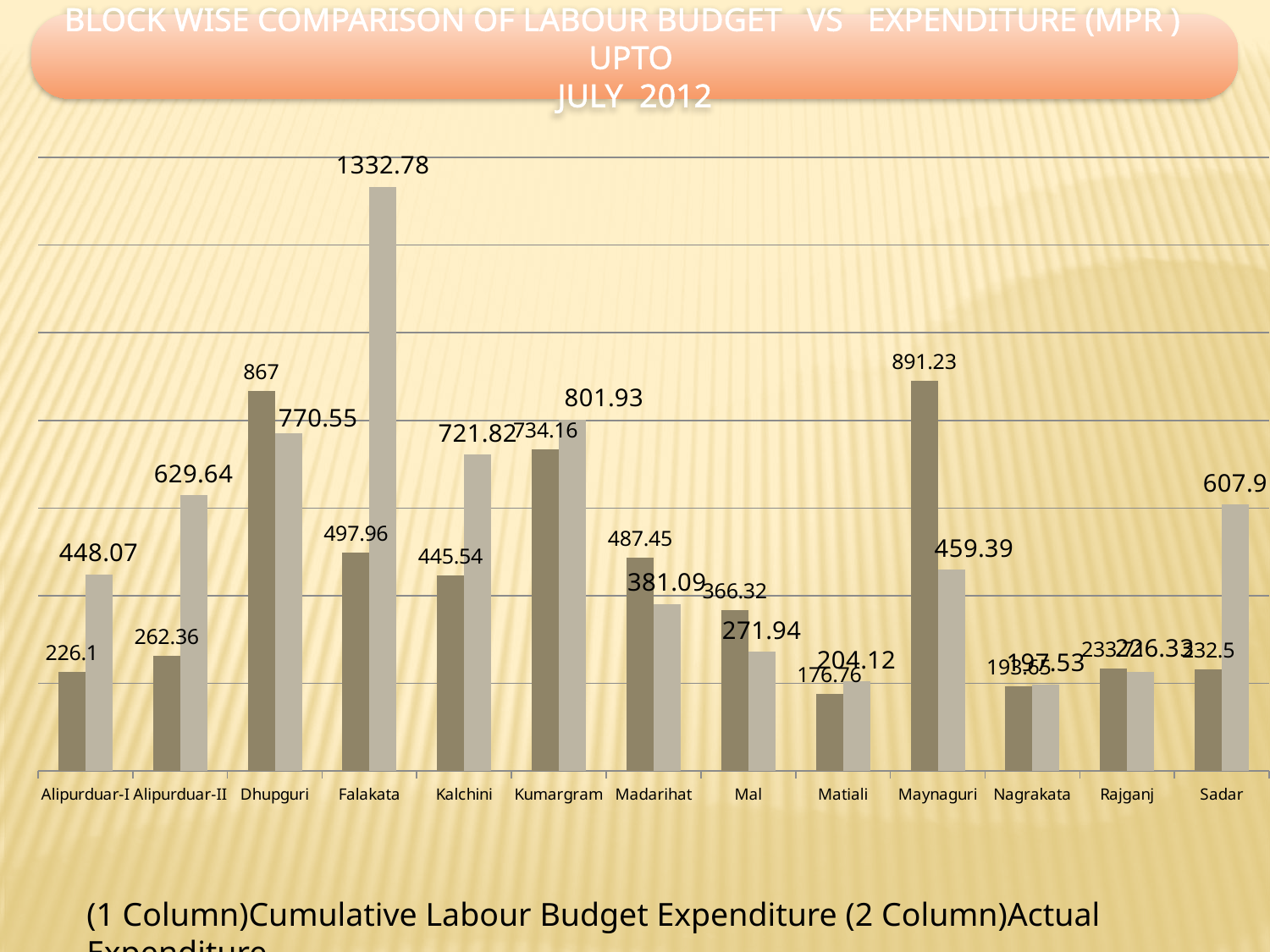
What kind of chart is shown on the slide? bar chart What is the title of the chart on the slide? BLOCK WISE COMPARISON OF LABOUR BUDGET VS EXPENDITURE (MPR) UPTO JULY 2012 How many blocks are shown along the x axis of the chart? 13 What is the Cumulative Labour Budget Expenditure value for Maynaguri? 891.23 What is the Actual Expenditure value for Kalchini? 721.82 What is the difference between the Actual Expenditure and the Cumulative Labour Budget Expenditure for Alipurduar-I? 221.97 For Kumargram, which is larger: the Cumulative Labour Budget Expenditure or the Actual Expenditure? Actual Expenditure What is the Actual Expenditure value for Sadar? 607.9 Which block has the highest Actual Expenditure? Falakata What is the difference between the Cumulative Labour Budget Expenditure and the Actual Expenditure for Dhupguri? 96.45 What is the Actual Expenditure value for Falakata? 1332.78 Which block has the highest Cumulative Labour Budget Expenditure? Maynaguri